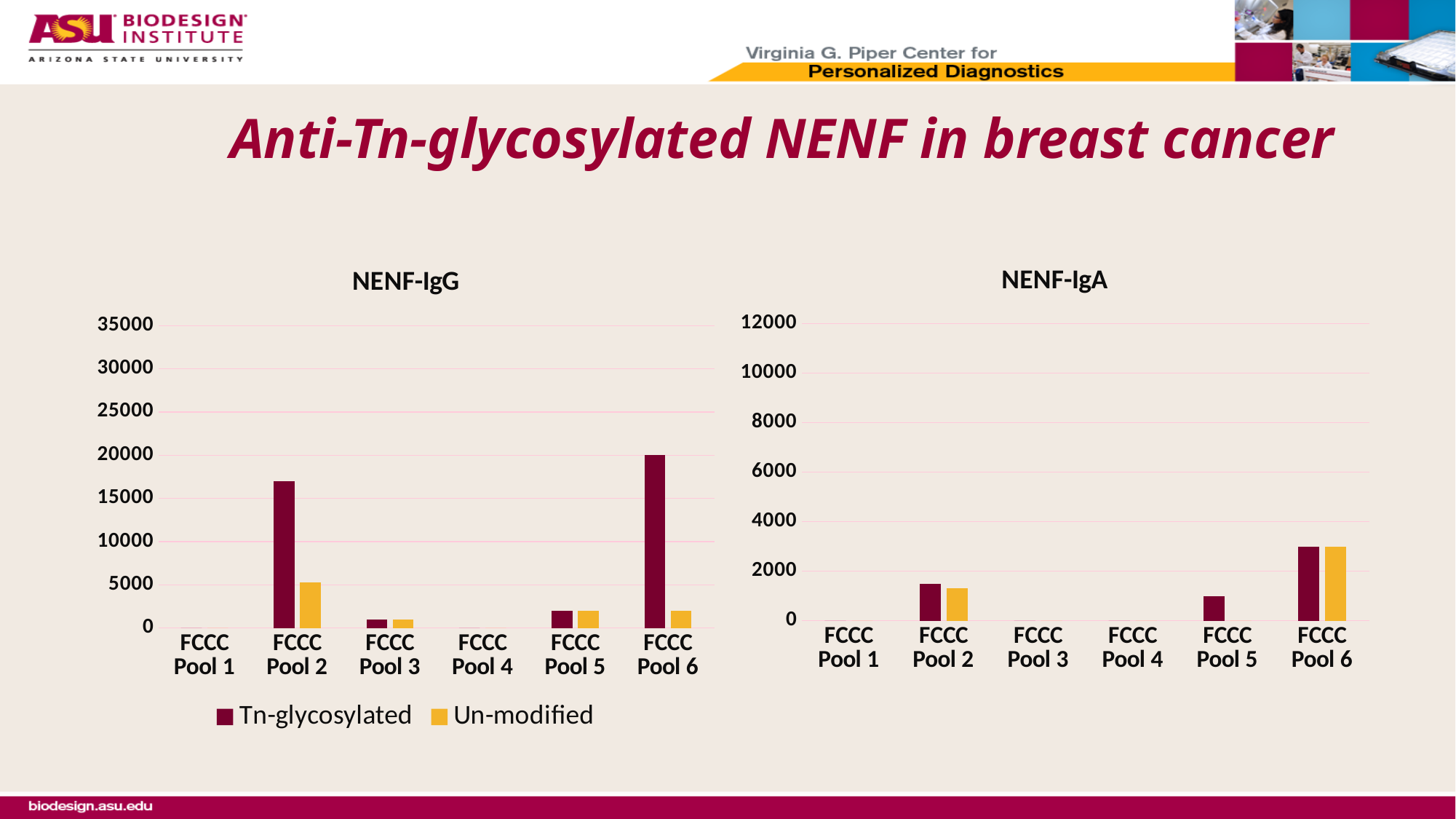
How many categories are shown on the x axis of the NENF-IgA chart? 6 In the NENF-IgA chart, which pool has the highest Tn-glycosylated value? FCCC Pool 6 In the NENF-IgG chart, which is larger for FCCC Pool 2: the Tn-glycosylated value or the Un-modified value? Tn-glycosylated In the NENF-IgG chart, is the Un-modified value for FCCC Pool 2 greater or less than 10000? less In the NENF-IgG chart, which pool has the highest Tn-glycosylated value? FCCC Pool 6 In the NENF-IgA chart, is the Tn-glycosylated value for FCCC Pool 6 greater or less than 2000? greater In the NENF-IgA chart, which is larger: the Tn-glycosylated value for FCCC Pool 2 or for FCCC Pool 5? FCCC Pool 2 What kind of chart is the NENF-IgG chart? bar chart In the NENF-IgG chart, is the Tn-glycosylated value for FCCC Pool 2 greater or less than 15000? greater How many series does the legend list? 2 Which series is shown in yellow in the legend? Un-modified